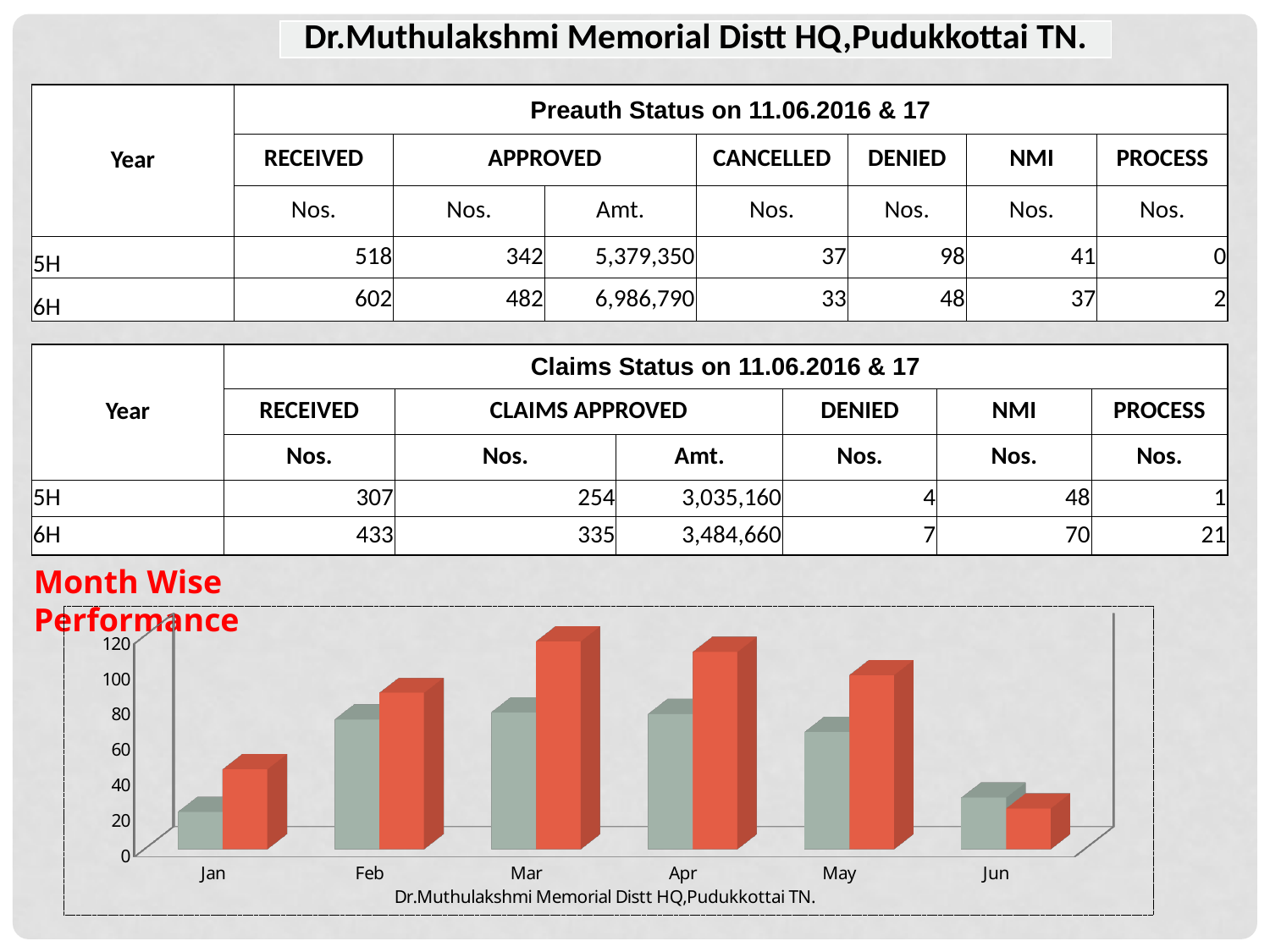
In the bar chart, which month has the lowest orange bar? Jun Is the grey bar for Feb greater or less than 60? greater What kind of chart is shown under the heading 'Month Wise Performance'? bar chart Is the orange bar for Mar greater or less than 100? greater Is the orange bar for Jan greater or less than 60? less How many months are shown on the x axis of the bar chart? 6 Do the orange bars rise or fall from Mar to Jun? fall How many bars are plotted for each month in the bar chart? 2 In Jan, which bar is taller, the grey bar or the orange bar? the orange bar What text appears as the axis title below the month labels of the bar chart? Dr.Muthulakshmi Memorial Distt HQ,Pudukkottai TN. In the bar chart, which month has the lowest grey bar? Jan